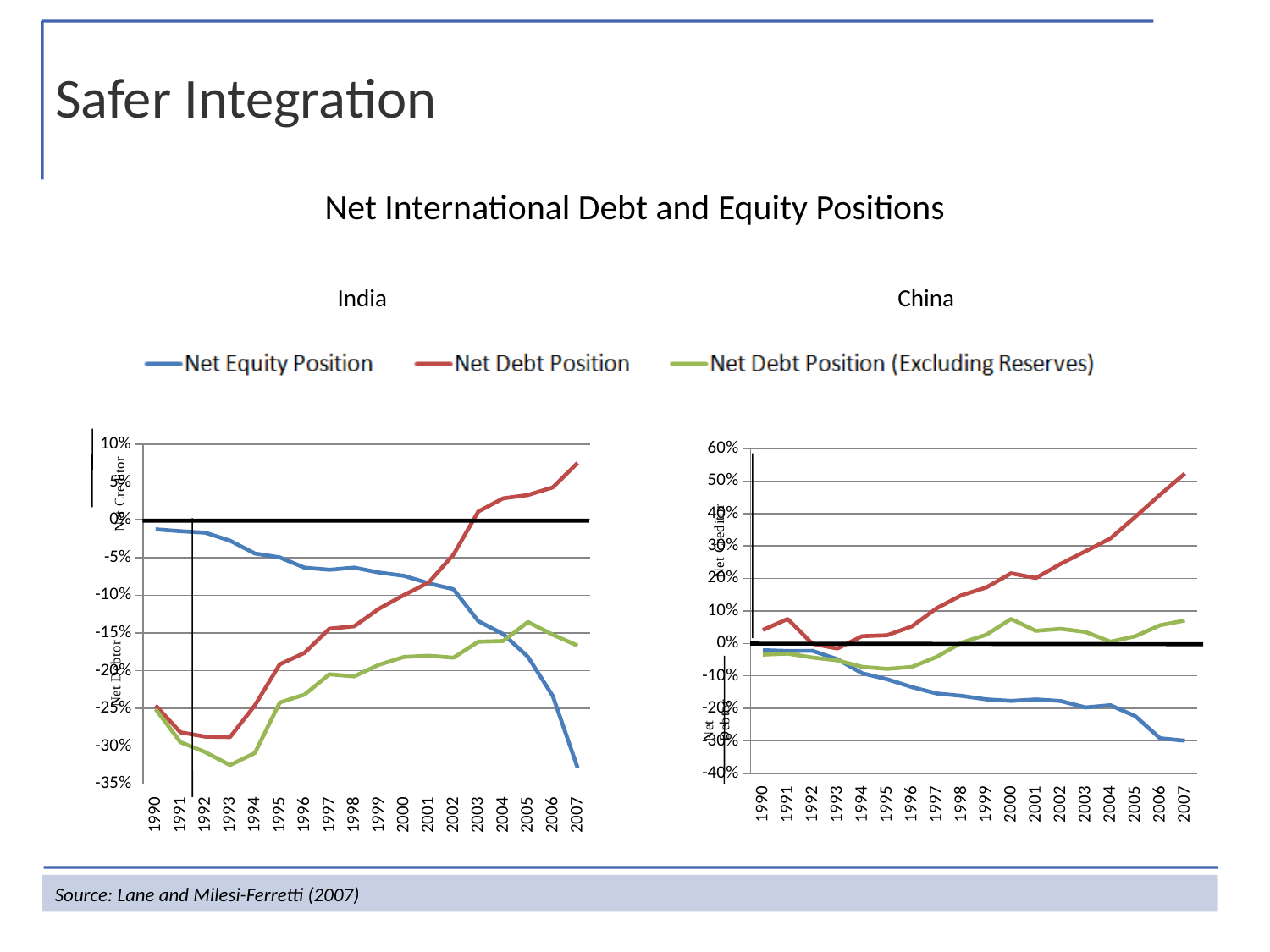
In the India chart, which year has the lowest Net Debt Position (Excluding Reserves)? 1993 In the China chart, which year has the highest Net Debt Position? 2007 In the India chart, is the Net Debt Position in 2007 greater or less than 5%? greater In the China chart, is the Net Debt Position in 2007 greater or less than 40%? greater In the India chart, does the Net Equity Position rise or fall from 1990 to 2007? fall How many years are plotted along the x axis of the China chart? 18 How many series does the legend list? 3 In the India chart, is the Net Equity Position in 2007 greater or less than -30%? less In the China chart, does the Net Debt Position rise or fall from 1990 to 2007? rise In the China chart, which is larger in 2007: the Net Debt Position or the Net Debt Position (Excluding Reserves)? Net Debt Position What kind of chart is the India chart? line chart